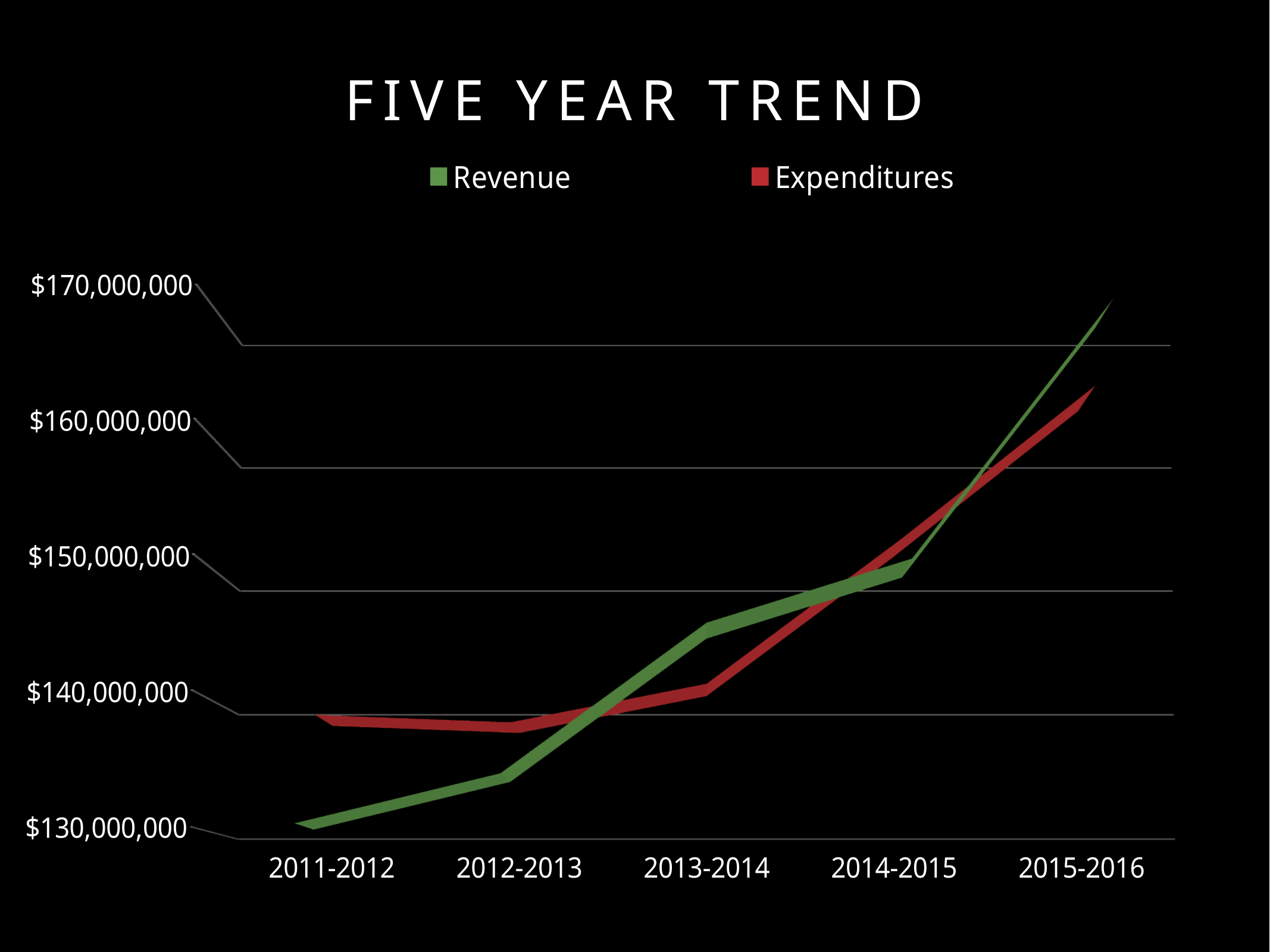
Is the Revenue value for 2011-2012 greater or less than $140,000,000? less In which period is Revenue lowest? 2011-2012 Which colour represents Expenditures in the legend? Red In 2015-2016, which is larger, Revenue or Expenditures? Revenue In which period are Expenditures highest? 2015-2016 How many fiscal-year periods are shown on the x axis? 5 Does Revenue generally rise or fall from 2011-2012 to 2015-2016? Rise In 2011-2012, which is larger, Revenue or Expenditures? Expenditures What kind of chart is shown on the slide? Line chart What is the title of the chart? FIVE YEAR TREND How many series does the legend list? 2 In which period is Revenue highest? 2015-2016